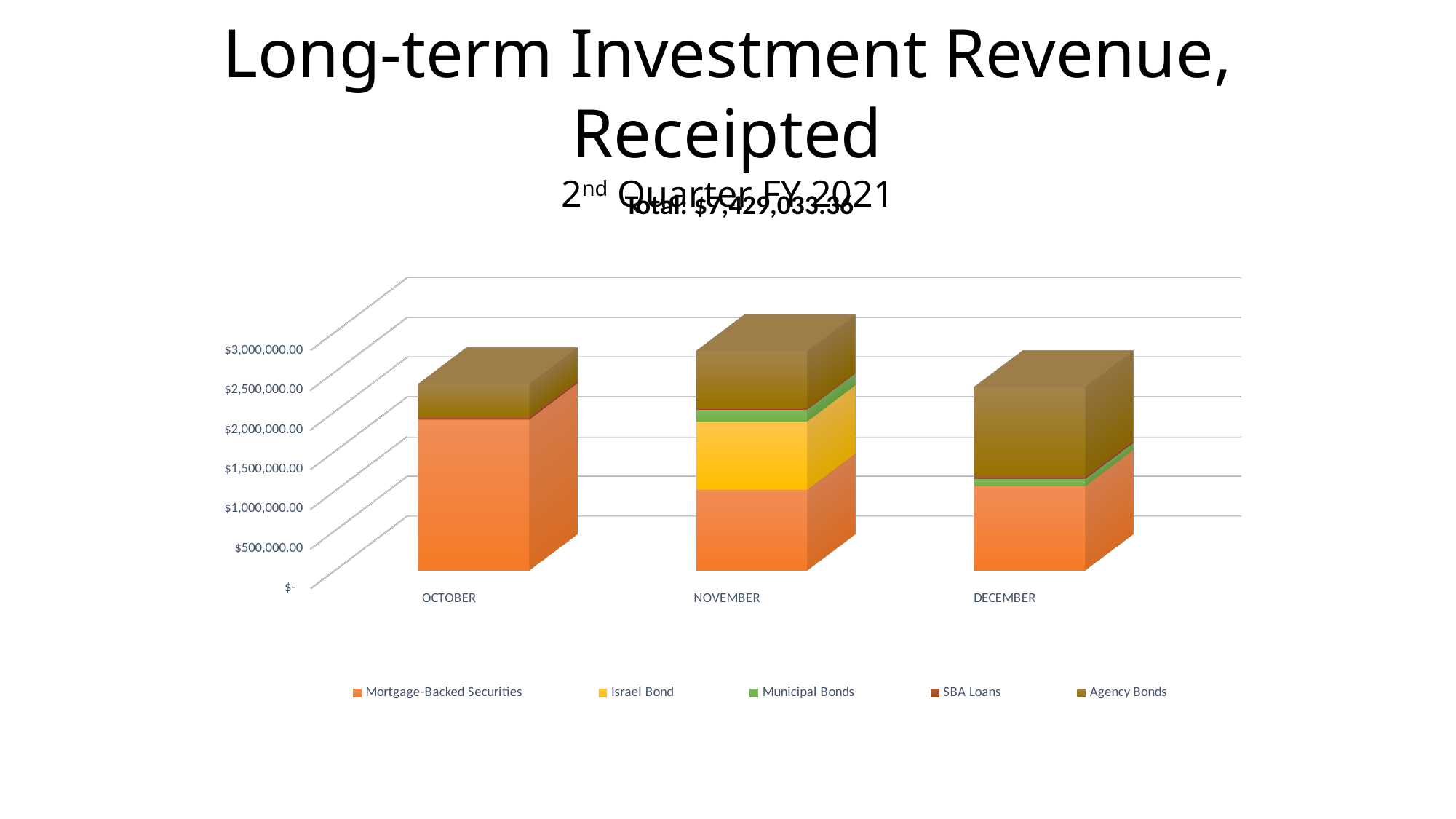
Is the Mortgage-Backed Securities value for October greater or less than $1,500,000.00? greater Is the Mortgage-Backed Securities value for December greater or less than $500,000.00? greater How many months are shown on the x axis of the chart? 3 Is the total bar for November greater or less than $2,000,000.00? greater What total amount is printed above the chart? $7,429,033.36 Which series is listed first in the chart legend? Mortgage-Backed Securities Which month has the largest Agency Bonds segment? December How many series does the chart legend list? 5 Which month has the highest total long-term investment revenue? November Which month has the largest Mortgage-Backed Securities segment? October Which is larger, the Mortgage-Backed Securities value for October or for November? October What kind of chart is shown on the slide? Stacked bar chart